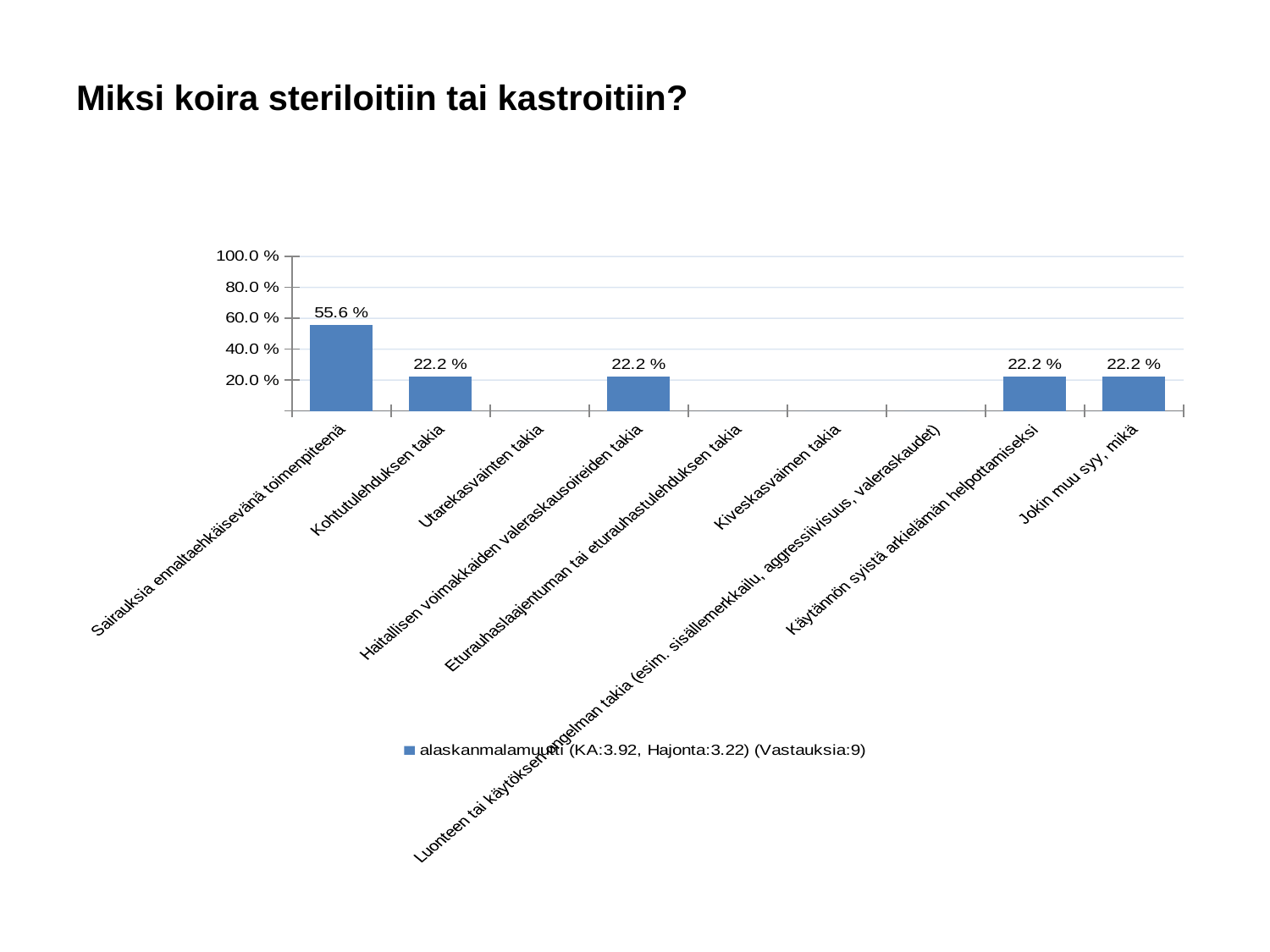
What is the title of the slide? Miksi koira steriloitiin tai kastroitiin? What is the value for "Jokin muu syy, mikä"? 22.2 % Which category has the highest value? Sairauksia ennaltaehkäisevänä toimenpiteenä How many categories have a value of 22.2 %? 4 What is the value for "Kohtutulehduksen takia"? 22.2 % Which is larger: the value for "Sairauksia ennaltaehkäisevänä toimenpiteenä" or the value for "Haitallisen voimakkaiden valeraskausoireiden takia"? Sairauksia ennaltaehkäisevänä toimenpiteenä What kind of chart is shown on the slide? bar chart What is the value for "Sairauksia ennaltaehkäisevänä toimenpiteenä"? 55.6 % Is the value for "Sairauksia ennaltaehkäisevänä toimenpiteenä" greater or less than 40.0 %? greater What is the difference between the value for "Sairauksia ennaltaehkäisevänä toimenpiteenä" and the value for "Käytännön syistä arkielämän helpottamiseksi"? 33.4 % How many series does the legend list? 1 How many categories are shown on the x axis? 9